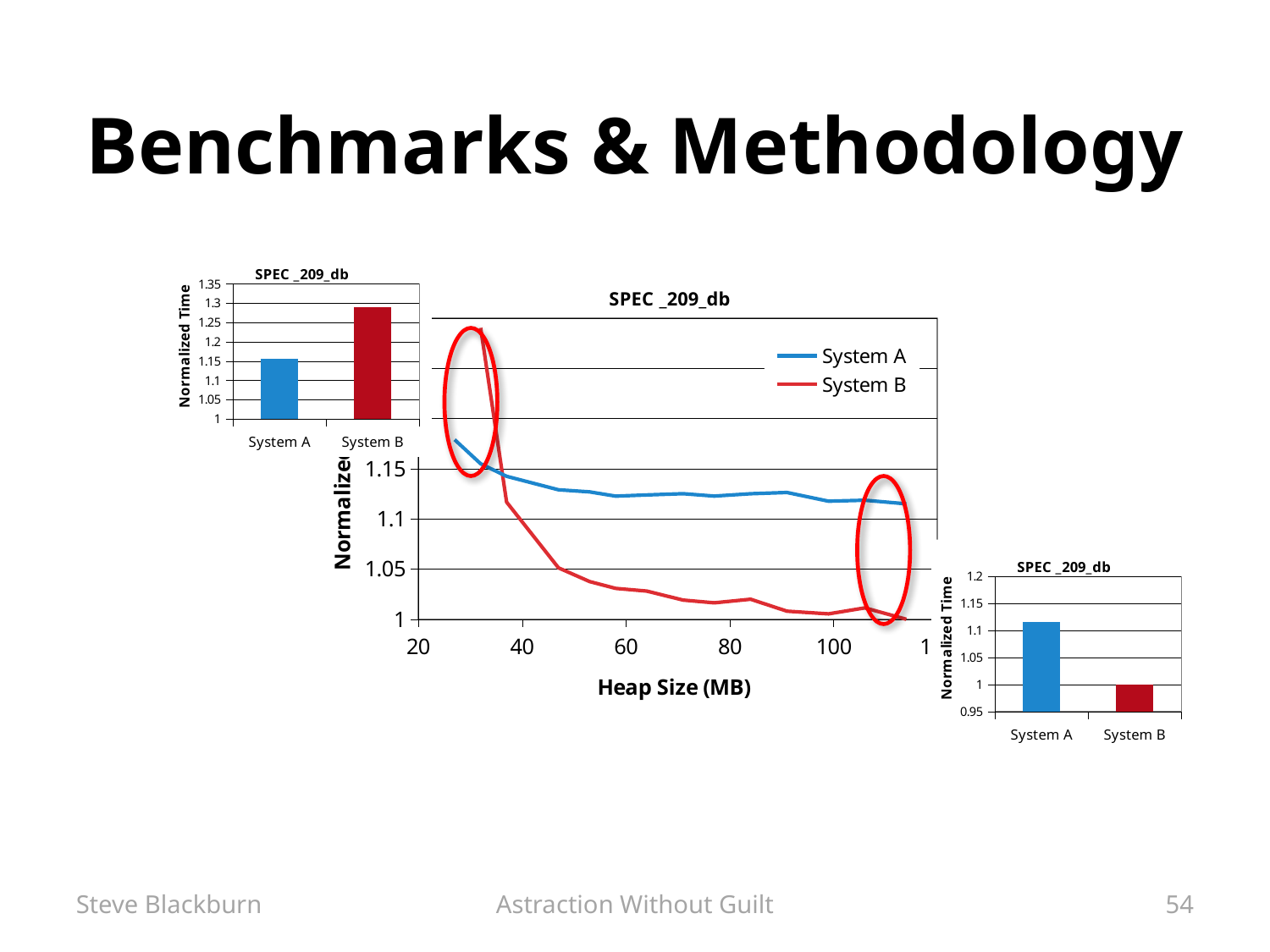
What kind of chart is the large chart in the centre of the slide? line chart In the centre line chart, which series has the higher value at a heap size of 60 MB? System A In the centre line chart, what is the title of the x axis? Heap Size (MB) What kind of chart is the small chart in the top-left of the slide? bar chart In the bottom-right bar chart, which system has the lower normalized time? System B In the bottom-right bar chart, is the value for System A greater or less than 1.05? greater In the top-left bar chart, is the value for System B greater or less than 1.25? greater How many series does the legend of the centre line chart list? 2 In the centre line chart, is the value for System B at a heap size of 100 MB greater or less than 1.05? less In the top-left bar chart, which system has the higher normalized time? System B In the centre line chart, does the System B line rise or fall as heap size increases? fall